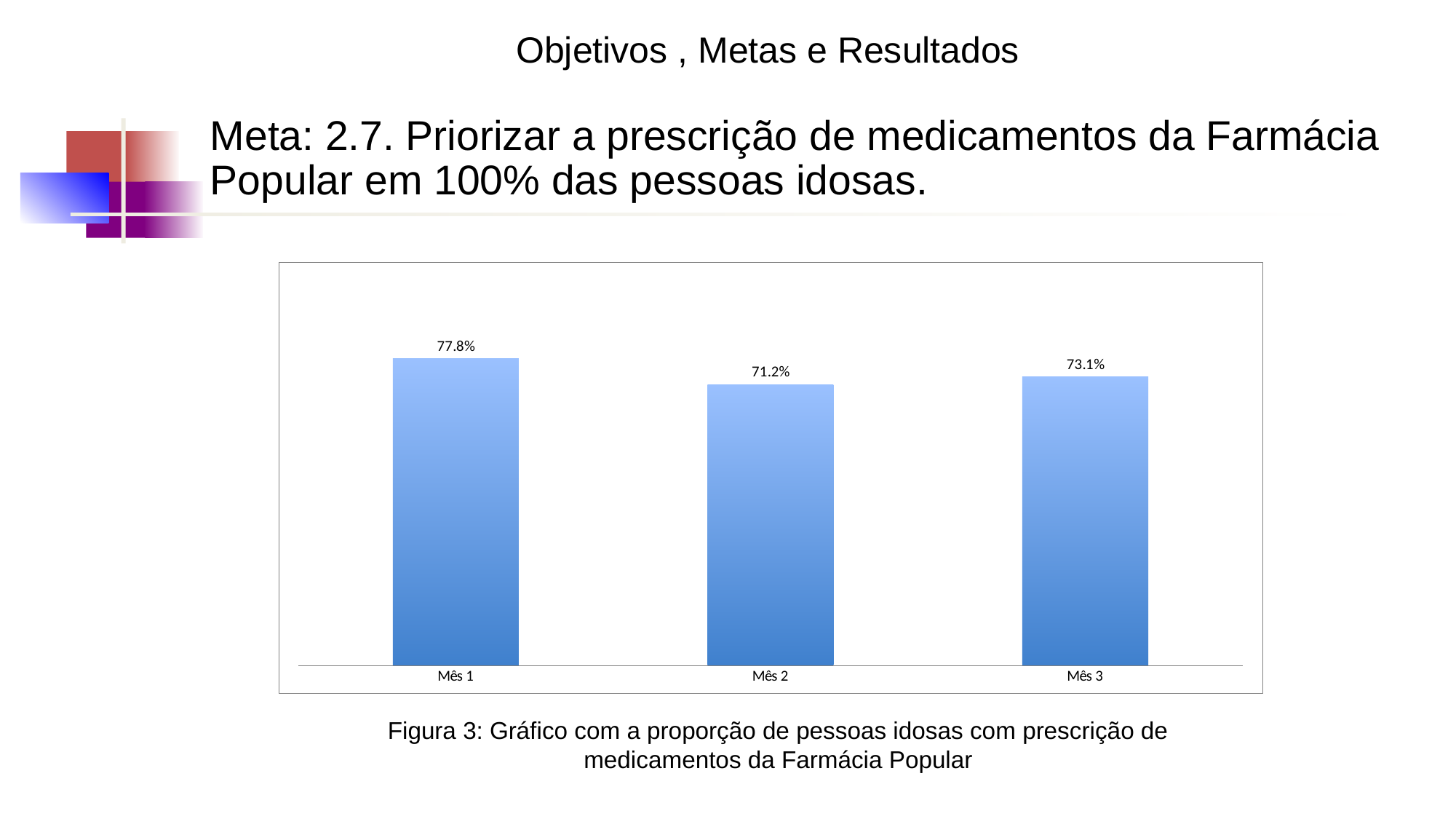
What kind of chart is shown on the slide? Bar chart Which month has the highest value? Mês 1 What is the value for Mês 3? 73.1% How many bars are shown in the chart? 3 What is the value for Mês 1? 77.8% Which month has the lowest value? Mês 2 What is the value for Mês 2? 71.2% What is the difference between the values for Mês 1 and Mês 2? 6.6% What is the figure number given in the caption below the chart? Figura 3 Which is larger, the value for Mês 2 or Mês 3? Mês 3 Does the value rise or fall from Mês 1 to Mês 2? Fall What is the difference between the values for Mês 3 and Mês 2? 1.9%